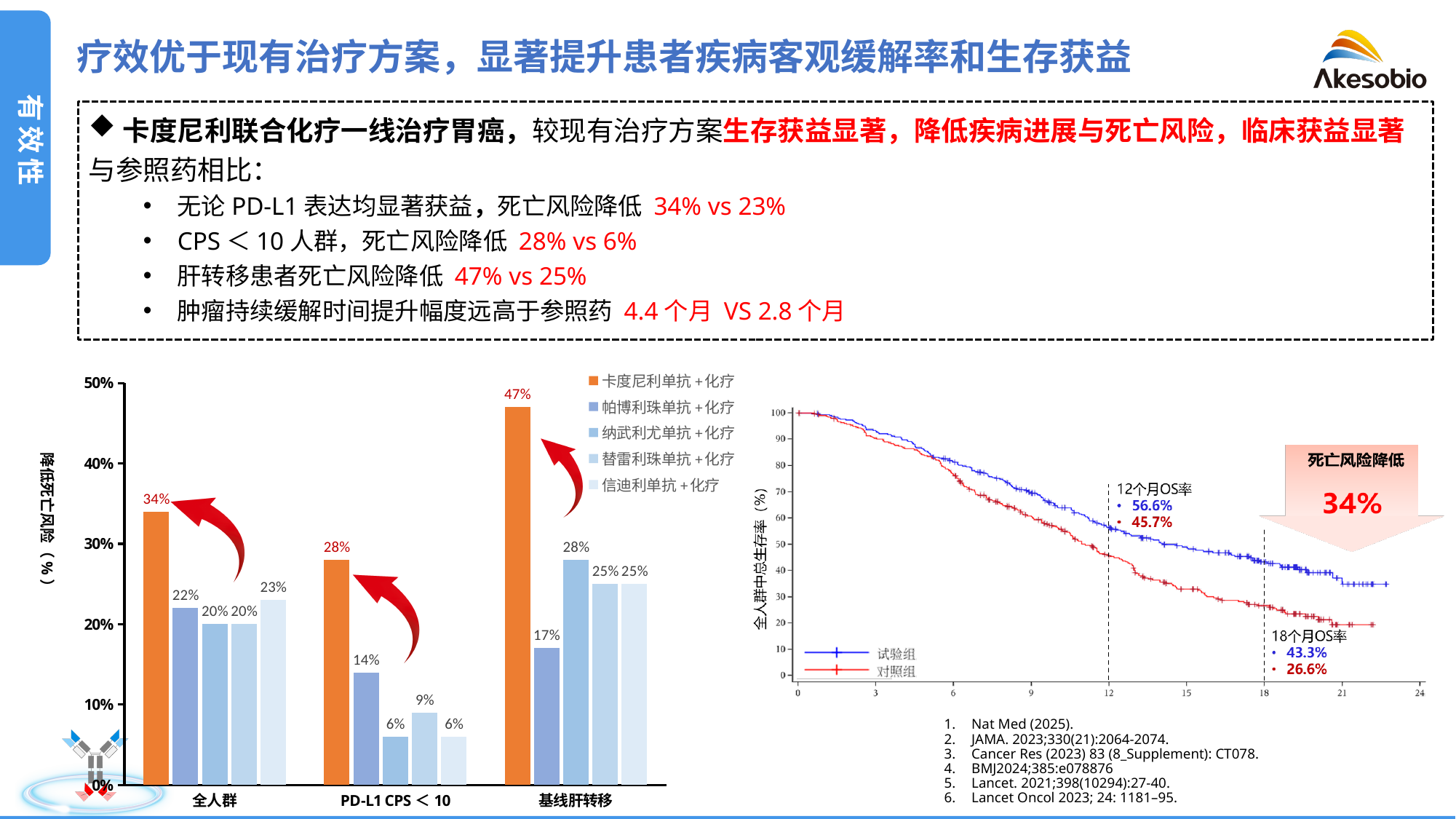
How many series does the legend of the left bar chart list? 5 On the left bar chart, what is the value for 帕博利珠单抗+化疗 in the PD-L1 CPS＜10 group? 14% On the left bar chart, what is the difference between 卡度尼利单抗+化疗 and 帕博利珠单抗+化疗 in the 全人群 group? 12% On the left bar chart, which series has the highest value in the 基线肝转移 group? 卡度尼利单抗+化疗 How many category groups are shown on the x axis of the left bar chart? 3 What kind of chart is the chart on the left of the slide? bar chart On the right survival curve chart, what is the 12个月OS率 for the 试验组? 56.6% On the left bar chart, what is the value for 纳武利尤单抗+化疗 in the 基线肝转移 group? 28% On the left bar chart, what is the value for 卡度尼利单抗+化疗 in the 全人群 group? 34% On the left bar chart, which is larger in the PD-L1 CPS＜10 group: 替雷利珠单抗+化疗 or 信迪利单抗+化疗? 替雷利珠单抗+化疗 On the right survival curve chart, what is the difference in 18个月OS率 between 试验组 and 对照组? 16.7% On the left bar chart, which series has the lowest value in the 基线肝转移 group? 帕博利珠单抗+化疗